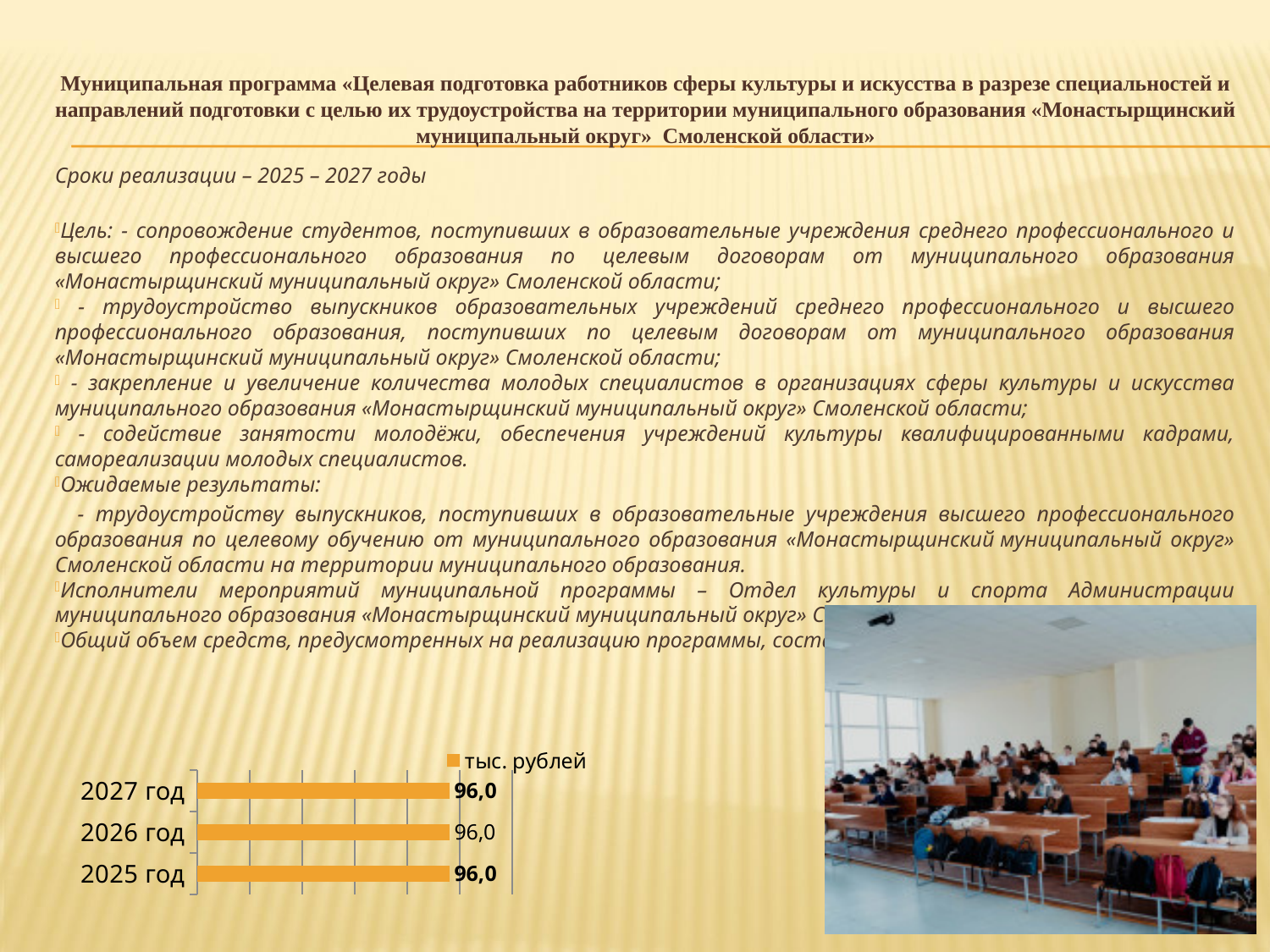
What colour are the bars in the chart? Orange What is the value for 2025 год in the bar chart? 96,0 What is the legend entry (unit) shown for the chart series? тыс. рублей How many series does the chart legend list? 1 How many categories (years) are shown in the bar chart? 3 What kind of chart is shown on the slide? Bar chart Do the values in the chart rise, fall, or stay the same from 2025 год to 2027 год? Stay the same What is the difference between the values for 2027 год and 2025 год? 0,0 What is the value for 2026 год in the bar chart? 96,0 What is the value for 2027 год in the bar chart? 96,0